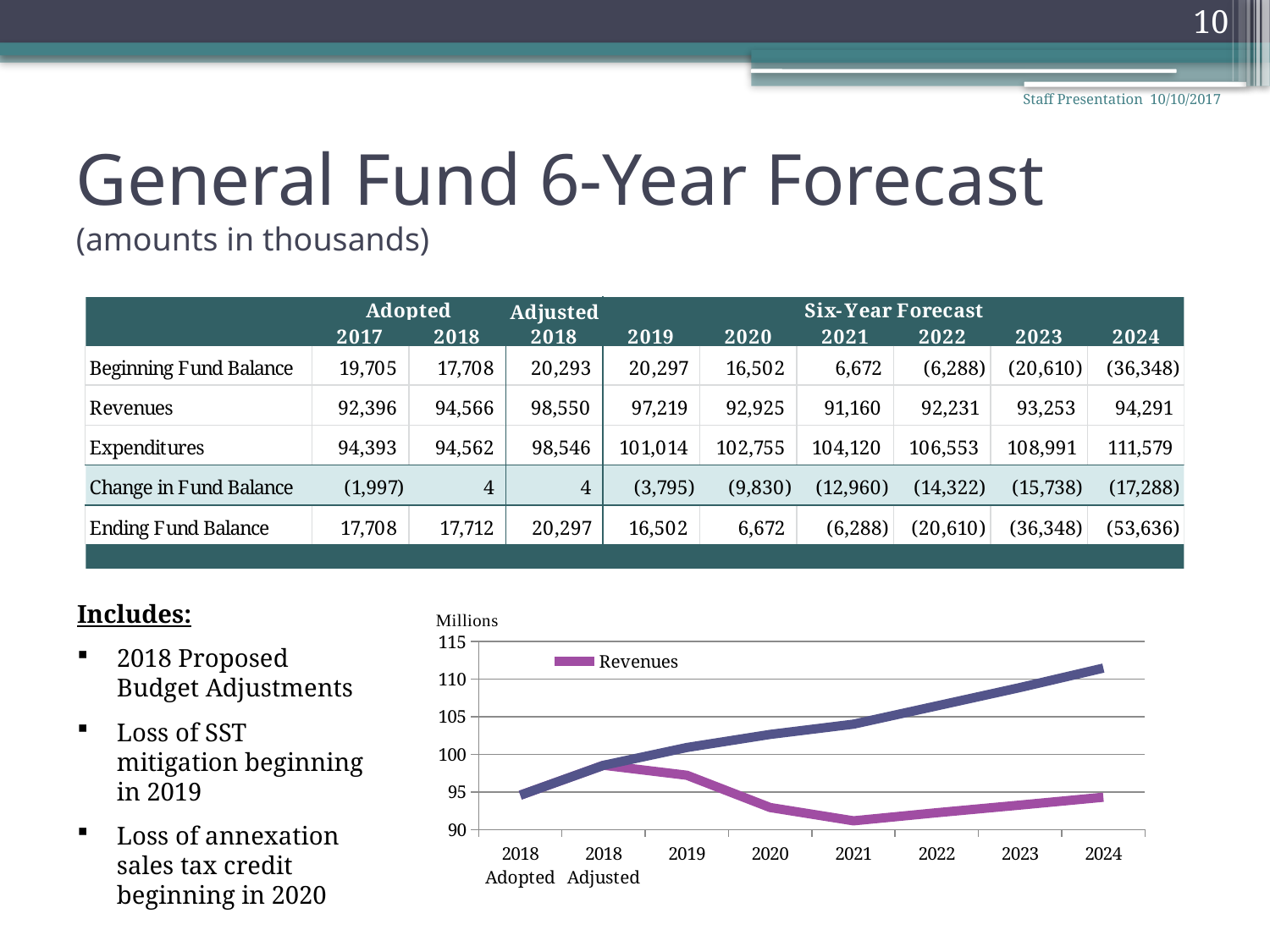
What unit label is shown above the chart's vertical axis? Millions What kind of chart is shown at the bottom of the slide? line chart In which year does the Revenues line reach its lowest point? 2021 Is the value of the dark blue line for 2024 greater or less than 110? greater How many series does the chart's legend list? 1 How many points are plotted along the x axis of the chart? 8 Is the Revenues value for 2018 Adjusted greater or less than 95? greater Does the dark blue line rise or fall from 2018 Adopted to 2024? rise Is the Revenues value for 2021 greater or less than 95? less What series name appears in the chart's legend? Revenues In 2024, which line is higher, the Revenues line or the dark blue line? the dark blue line